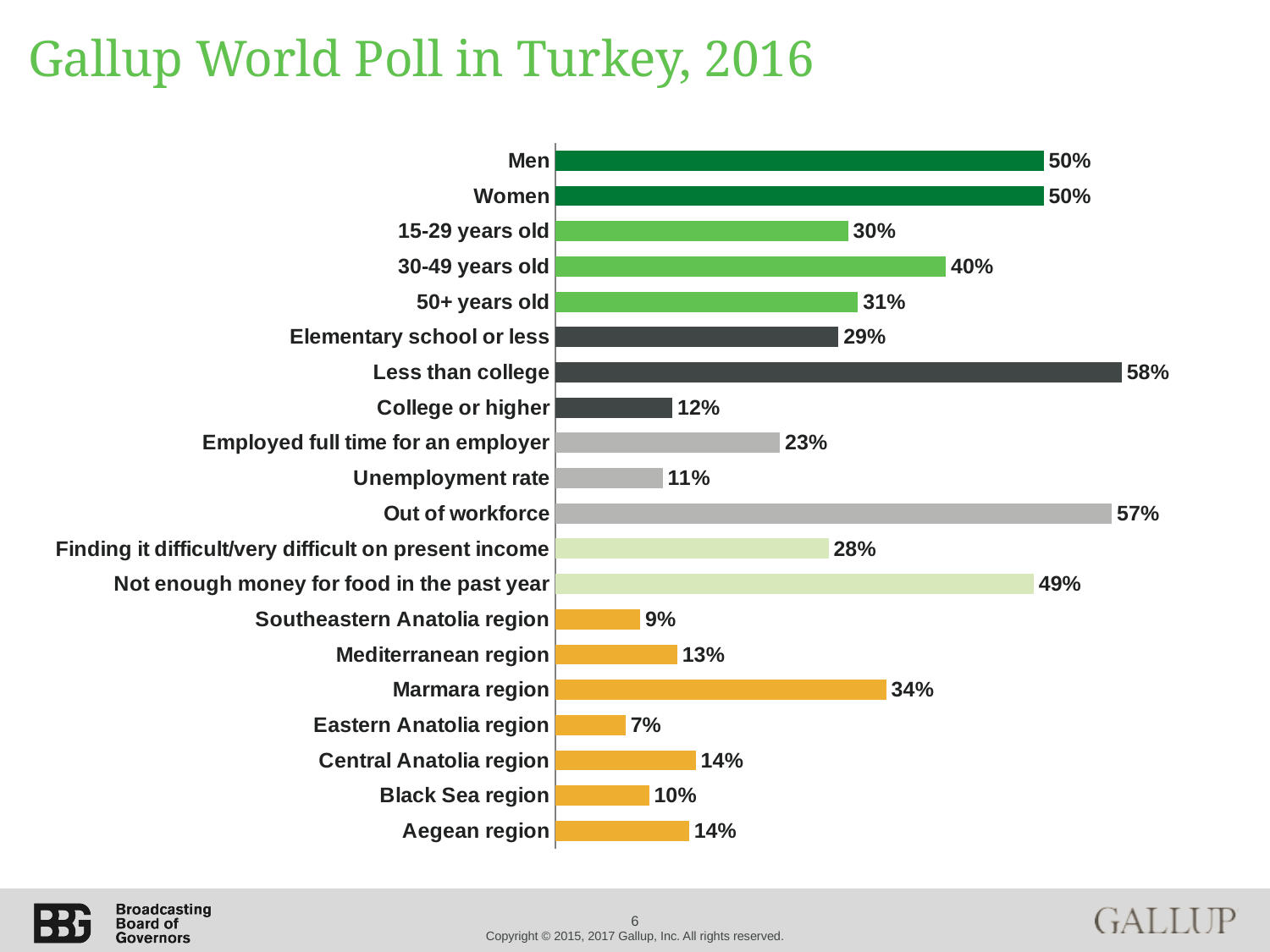
What kind of chart is shown on the slide? Bar chart What is the value for Eastern Anatolia region? 7% What is the value for Out of workforce? 57% How many categories are shown in the chart? 20 Which category has the lowest value? Eastern Anatolia region What is the value for 30-49 years old? 40% What is the difference between the values for Not enough money for food in the past year and Finding it difficult/very difficult on present income? 21% What is the difference between the values for Less than college and College or higher? 46% What is the value for Men? 50% What is the title of the slide? Gallup World Poll in Turkey, 2016 Which category has the highest value? Less than college Which is larger, the value for Marmara region or the value for Mediterranean region? Marmara region